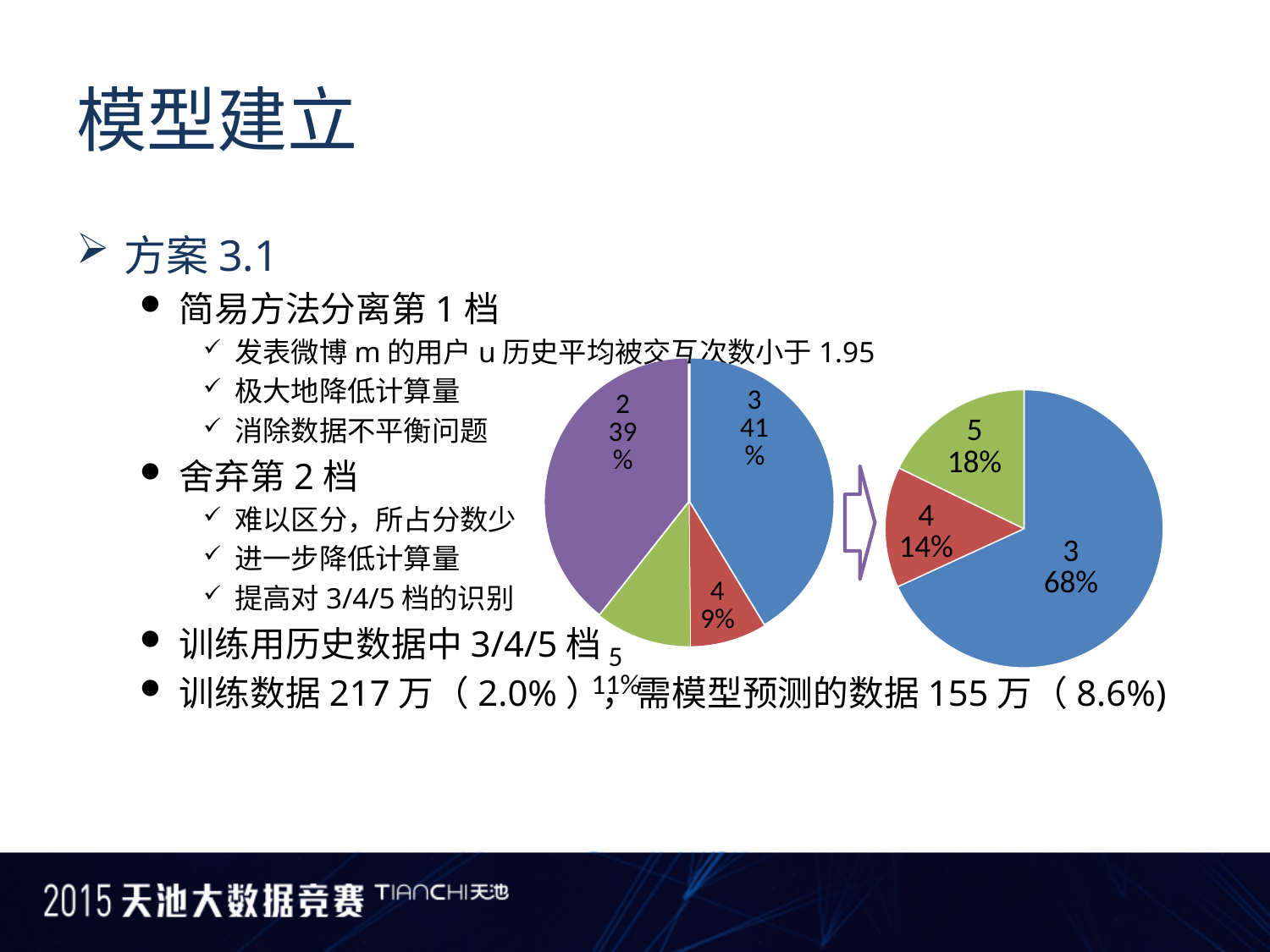
In the right pie chart, which category has the smallest slice? 4 In the right pie chart, what share does category 3 have? 68% In the right pie chart, which category has the largest slice? 3 In the left pie chart, what share does category 4 have? 9% In the left pie chart, what share does category 3 have? 41% In the right pie chart, what is the difference in percentage points between category 3 and category 5? 50 How many slices does the right pie chart have? 3 In the left pie chart, what share does category 2 have? 39% In the left pie chart, which category has the smallest slice? 4 What type of chart is shown on the left side of the slide? Pie chart In the right pie chart, what share does category 4 have? 14% In the right pie chart, what share does category 5 have? 18%